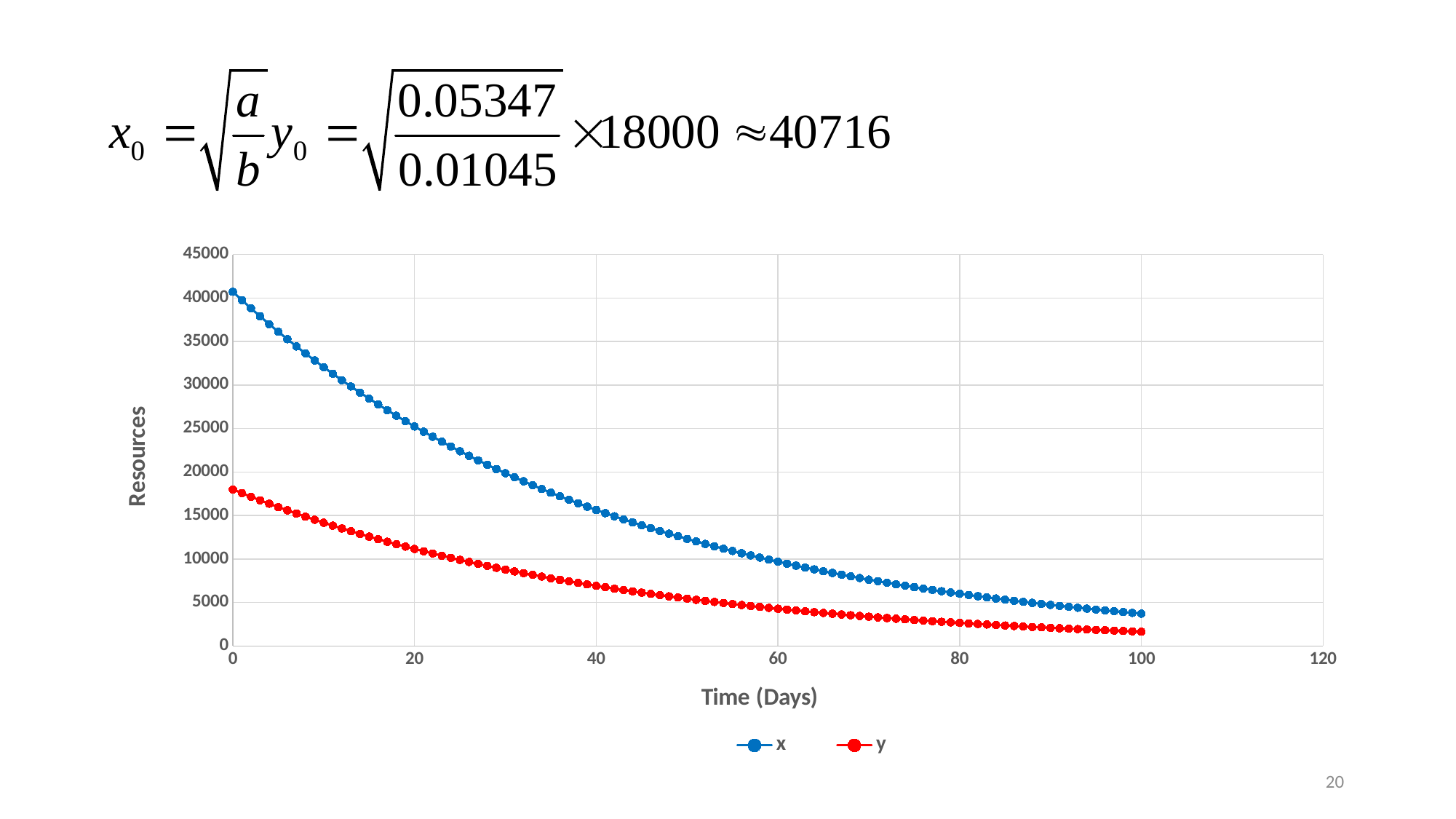
Is the value of series x at day 100 greater or less than 5000? less At day 0, which series has the larger value, x or y? x Is the value of series x at day 20 greater or less than 20000? greater How many series does the legend list? 2 Do the values of series x rise or fall as time increases along the x axis? fall Is the value of series x at day 0 greater or less than 35000? greater Do the values of series y rise or fall as time increases along the x axis? fall What kind of chart is shown on the slide? line chart What is the title of the horizontal axis? Time (Days) What is the title of the vertical axis? Resources